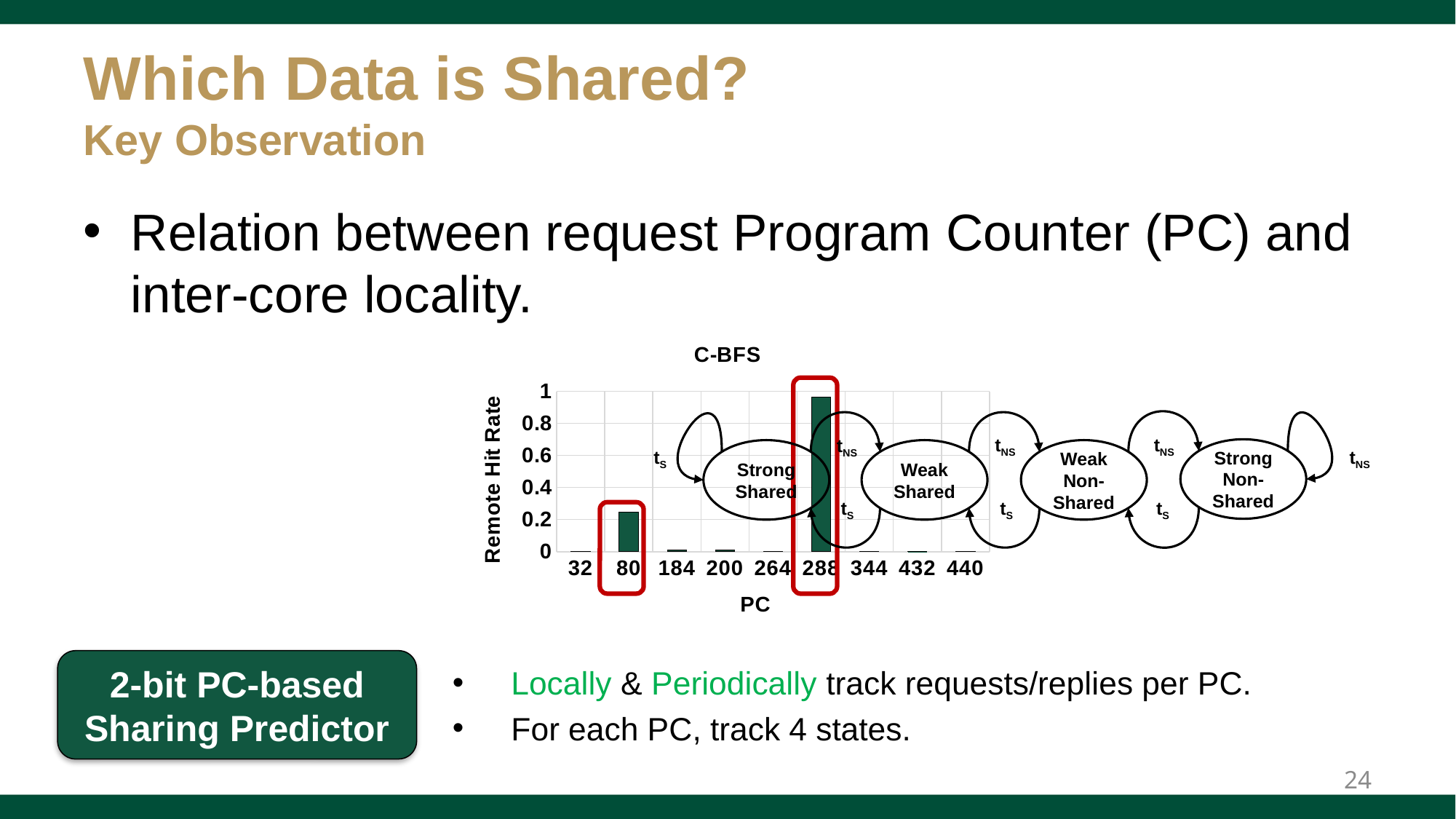
Is the Remote Hit Rate for PC 288 greater or less than 0.8? greater What is the label of the y-axis of the chart? Remote Hit Rate What is the title of the chart? C-BFS Which has a higher Remote Hit Rate, PC 80 or PC 288? 288 What type of chart is shown on the slide? bar chart Is the Remote Hit Rate for PC 288 greater or less than 0.6? greater Which PC has the highest Remote Hit Rate in the chart? 288 How many PC categories are shown on the x-axis of the chart? 9 Is the Remote Hit Rate for PC 184 greater or less than 0.2? less Which has a higher Remote Hit Rate, PC 80 or PC 344? 80